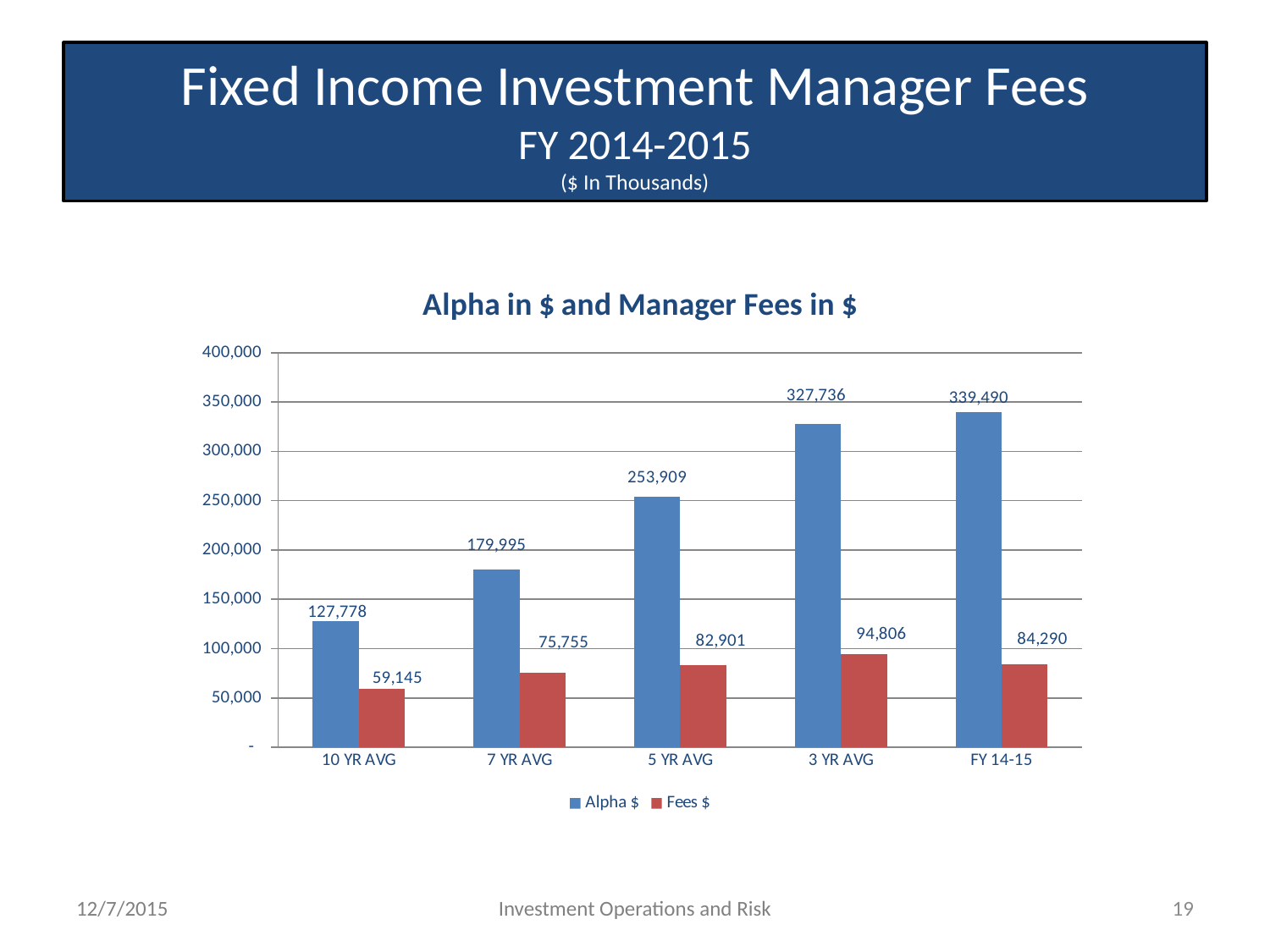
What is the difference between the Alpha $ and Fees $ values for 10 YR AVG? 68,633 What is the Alpha $ value for 5 YR AVG? 253,909 Which category has the highest Alpha $ value? FY 14-15 How many series does the legend list? 2 Which category has the lowest Fees $ value? 10 YR AVG What is the Fees $ value for 3 YR AVG? 94,806 What is the title of the chart? Alpha in $ and Manager Fees in $ What is the Alpha $ value for FY 14-15? 339,490 How many categories are shown on the x axis? 5 Which is larger: the Fees $ value for 3 YR AVG or the Fees $ value for FY 14-15? 3 YR AVG What kind of chart is shown on the slide? bar chart Is the Alpha $ value for 7 YR AVG greater or less than 200,000? less